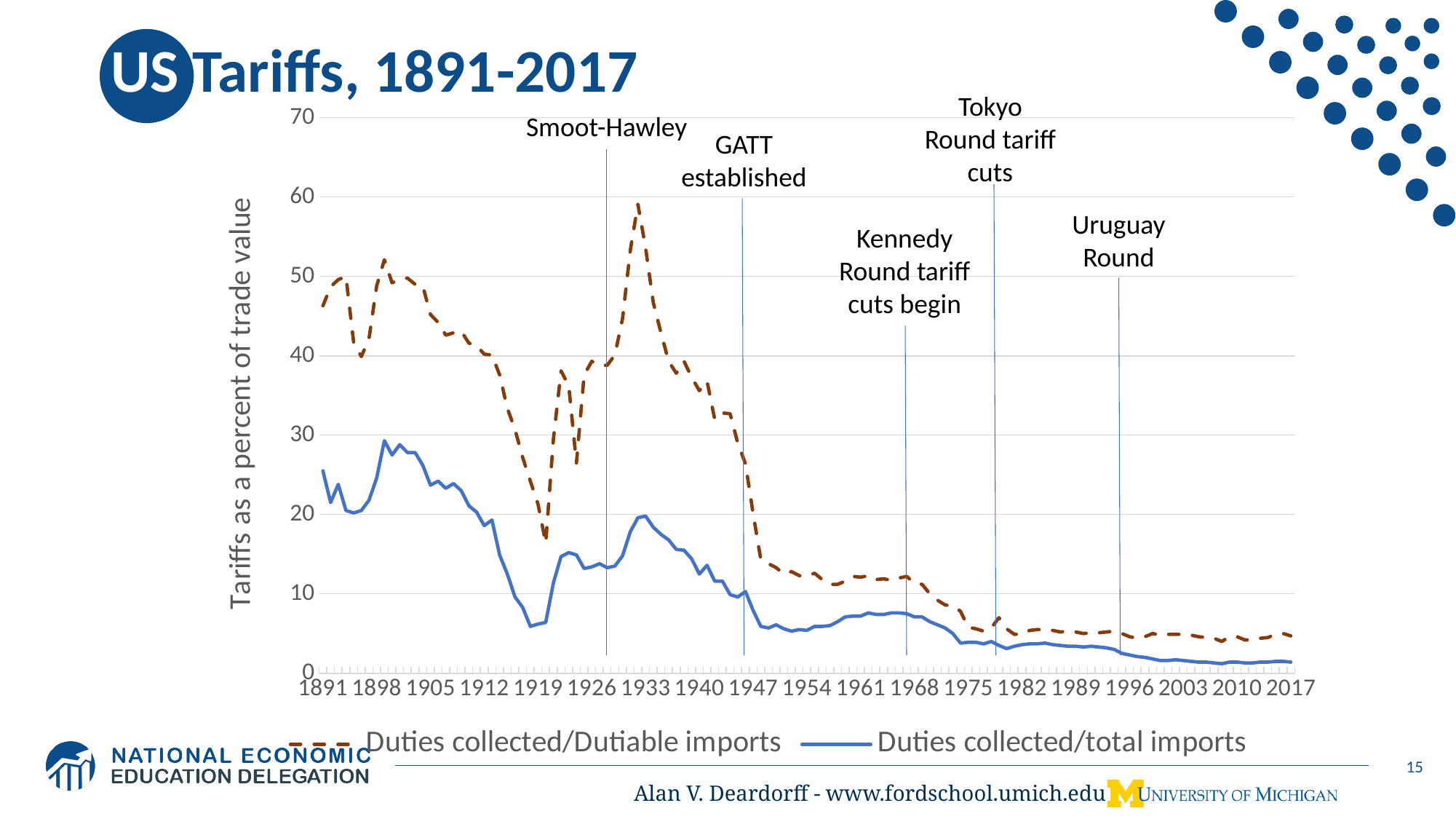
Overall, do the tariff values rise or fall from 1891 to 2017? fall Is the value of Duties collected/Dutiable imports in 1891 greater or less than 40? greater Is the value of Duties collected/total imports in 2017 greater or less than 10? less Is the peak value of Duties collected/Dutiable imports around 1933 greater or less than 50? greater What kind of chart is shown on the slide? line chart Which series is higher around 1933: Duties collected/Dutiable imports or Duties collected/total imports? Duties collected/Dutiable imports How many series does the legend list? 2 What are the two series named in the legend? Duties collected/Dutiable imports; Duties collected/total imports Which series reaches the higher maximum value over the whole period? Duties collected/Dutiable imports What is the label on the vertical axis? Tariffs as a percent of trade value